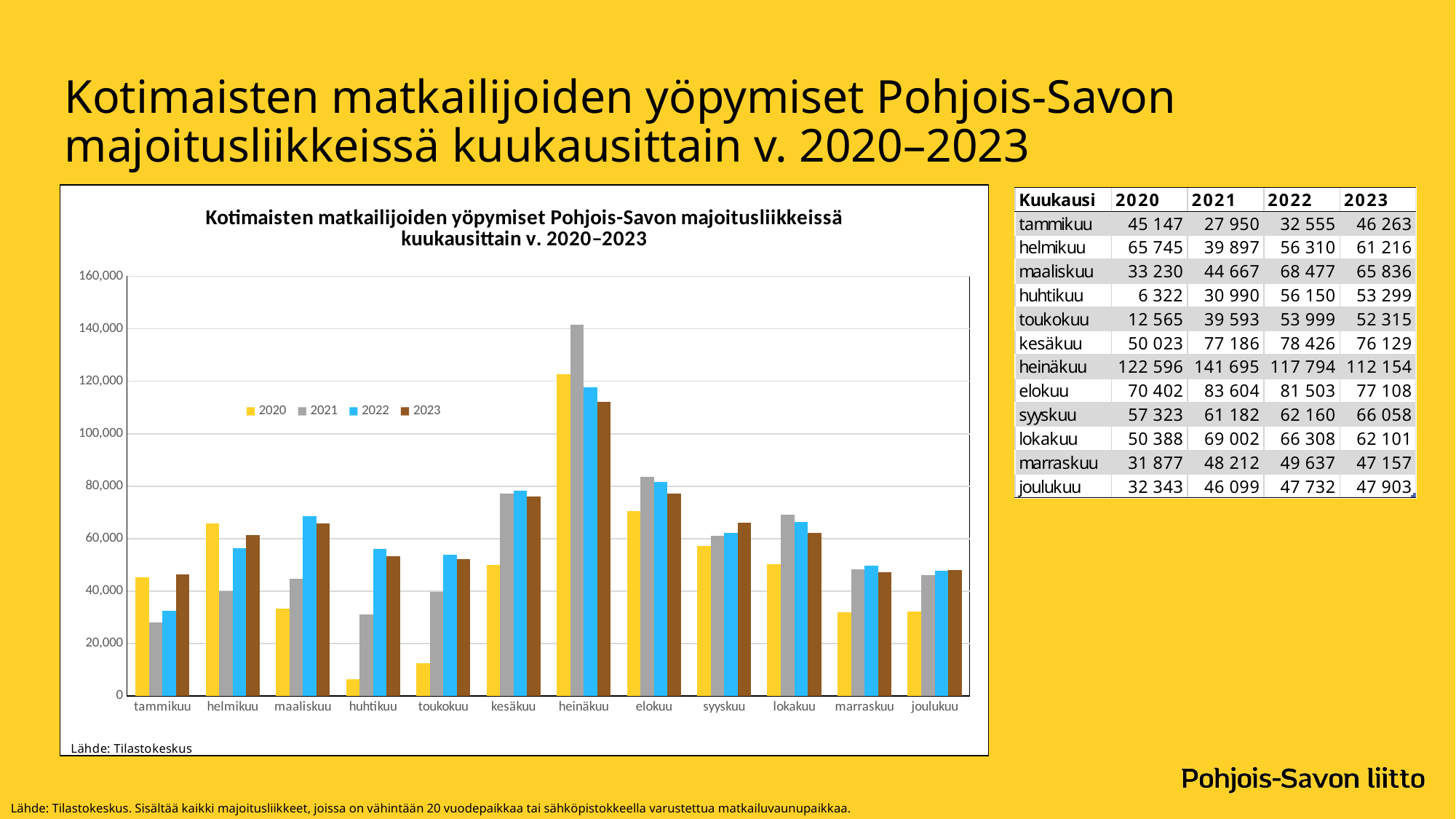
Which is larger for maaliskuu: the 2022 value or the 2023 value? 2022 Is the value for toukokuu in 2020 greater or less than 20,000? less Which month has the highest value for 2021? heinäkuu What source is cited below the chart? Tilastokeskus Which month has the lowest value for 2020? huhtikuu What type of chart is shown on the slide? bar chart Is the value for heinäkuu in 2021 greater or less than 140,000? greater What is the value for heinäkuu in 2021? 141 695 What is the difference between the 2020 and 2021 values for tammikuu? 17 197 How many series does the chart legend list? 4 What is the value for huhtikuu in 2020? 6 322 How many months (categories) are shown on the x axis of the chart? 12